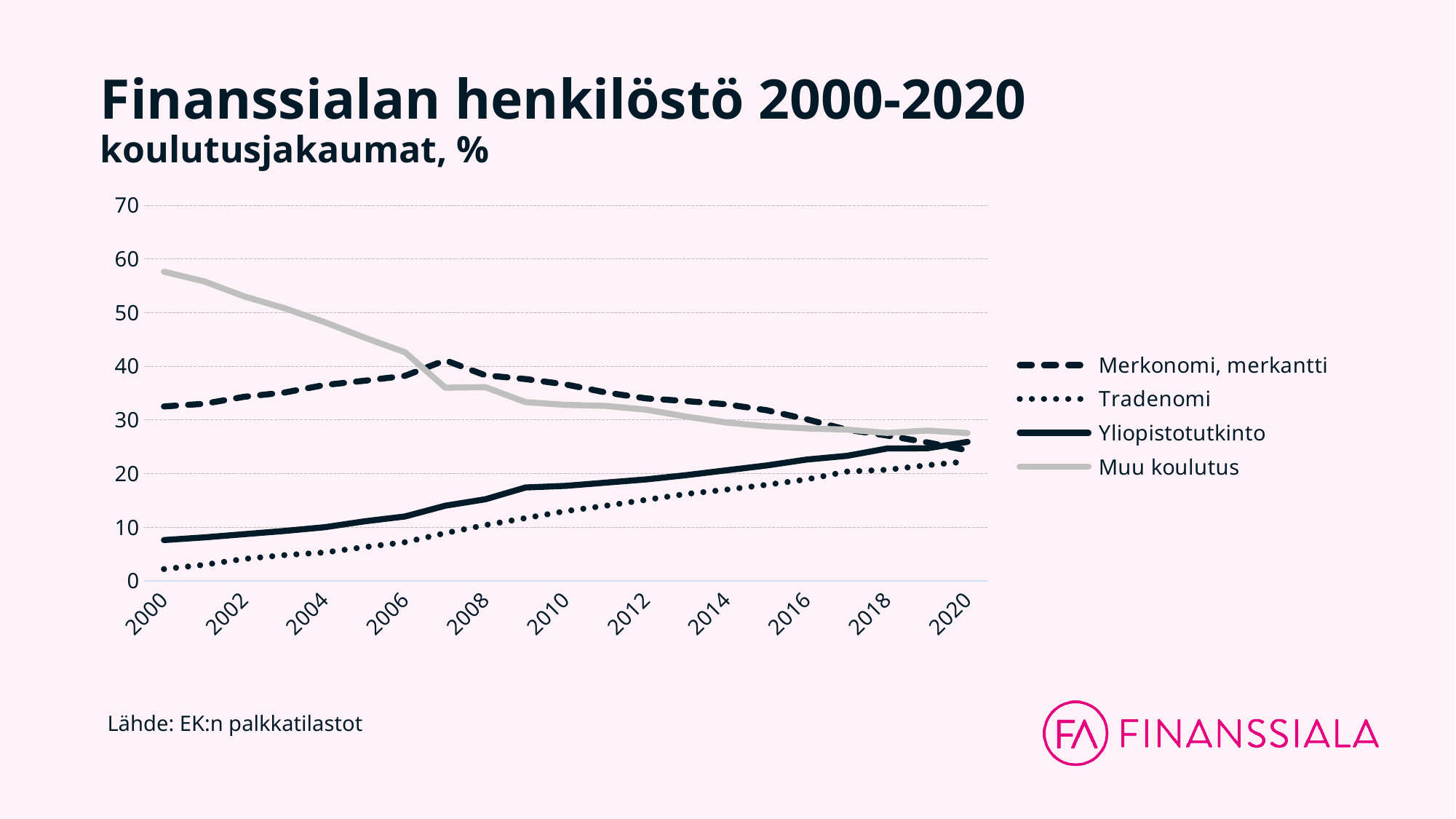
How many year labels are shown on the x axis? 11 Is the value for Tradenomi in 2000 greater or less than 10? less Which series has the lowest value in 2000? Tradenomi Is the value for Muu koulutus in 2020 greater or less than 30? less What is the title of the chart? Finanssialan henkilöstö 2000-2020 koulutusjakaumat, % In 2006, which is larger: Muu koulutus or Merkonomi, merkantti? Muu koulutus Which series has the highest value in 2000? Muu koulutus What kind of chart is shown on the slide? Line chart Is the value for Muu koulutus in 2000 greater or less than 50? greater Does the Tradenomi line rise or fall from 2000 to 2020? Rises How many series does the legend list? 4 Does the Muu koulutus line rise or fall from 2000 to 2020? Falls